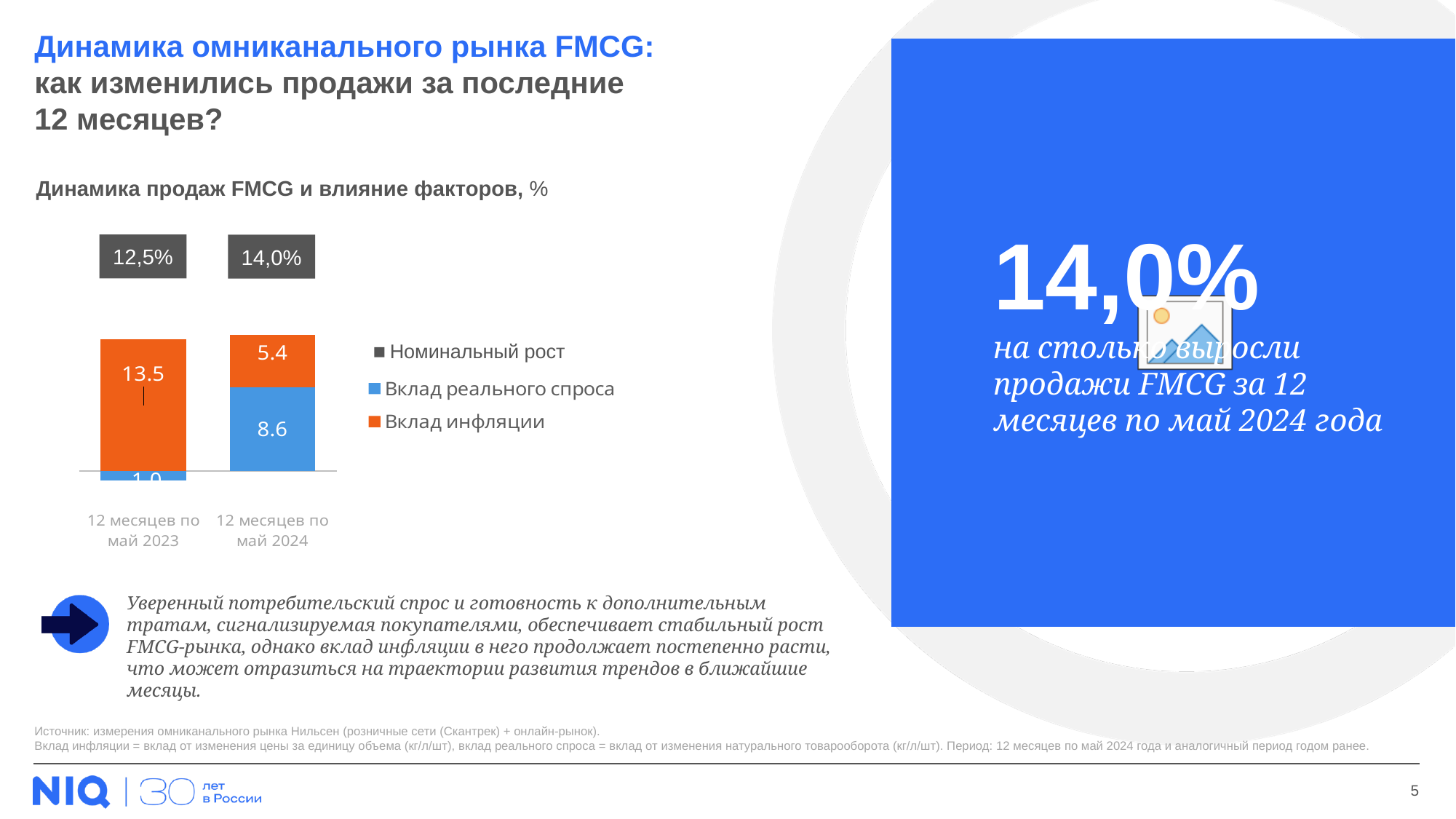
By how much did "Вклад инфляции" decrease from 12 месяцев по май 2023 (13.5) to 12 месяцев по май 2024 (5.4)? 8.1 How many series does the legend of the chart list? 3 What is the value of "Вклад инфляции" for "12 месяцев по май 2023"? 13.5 For "12 месяцев по май 2024", which is larger: "Вклад реального спроса" or "Вклад инфляции"? Вклад реального спроса What is the "Номинальный рост" value shown for "12 месяцев по май 2024"? 14,0% What is the value of "Вклад инфляции" for "12 месяцев по май 2024"? 5.4 What kind of chart is shown under the heading "Динамика продаж FMCG и влияние факторов, %"? Stacked bar chart What is the value of "Вклад реального спроса" for "12 месяцев по май 2024"? 8.6 Did the "Номинальный рост" value rise or fall from 12 месяцев по май 2023 to 12 месяцев по май 2024? Rise What is the "Номинальный рост" value shown for "12 месяцев по май 2023"? 12,5% Which period has the larger "Вклад инфляции": 12 месяцев по май 2023 or 12 месяцев по май 2024? 12 месяцев по май 2023 How many periods (categories) are shown on the x axis of the chart? 2